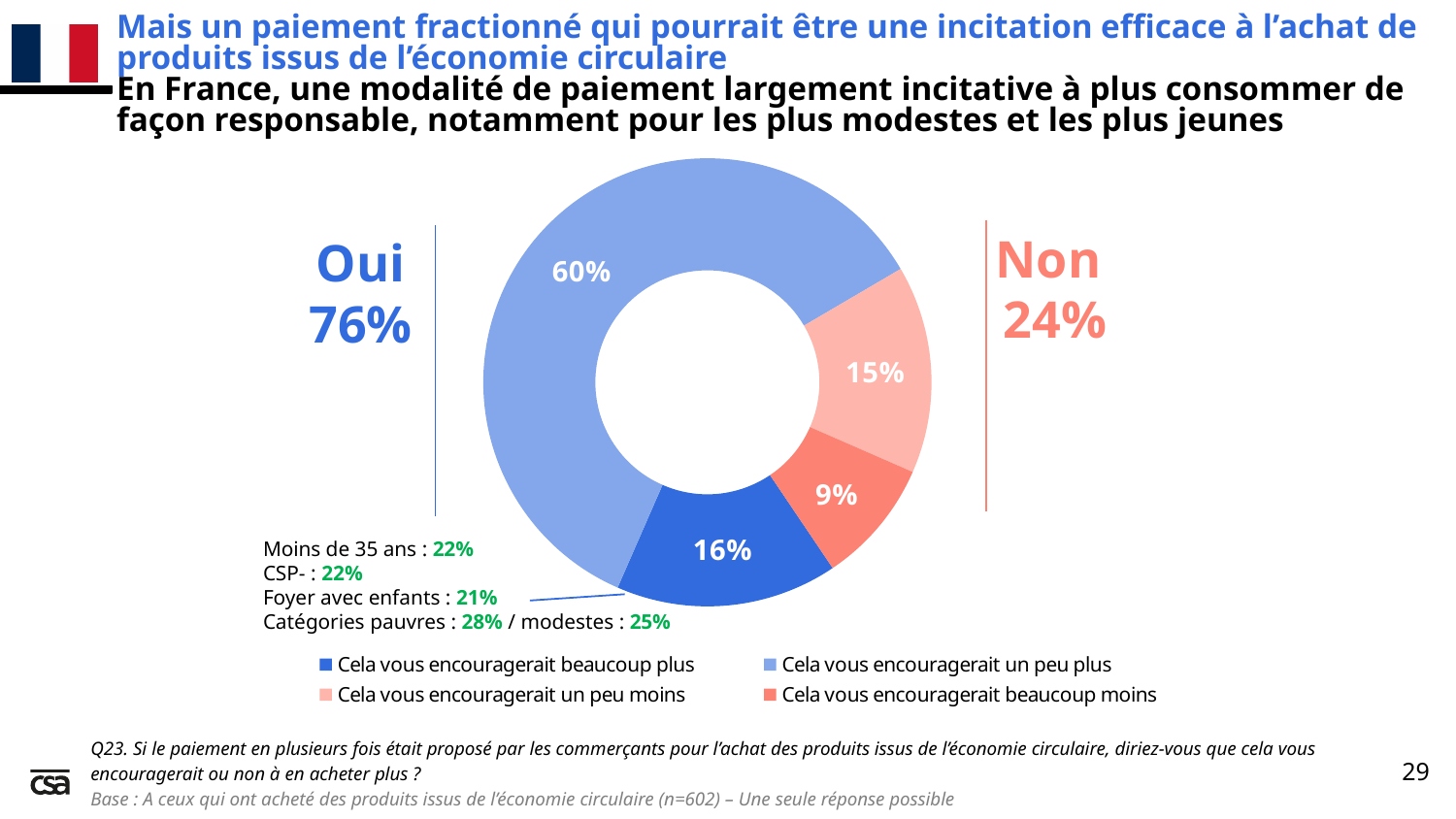
What total percentage is shown for "Non" on the slide? 24% What share of respondents answered "Cela vous encouragerait un peu plus"? 60% What total percentage is shown for "Oui" on the slide? 76% What kind of chart is shown on the slide? Pie chart (donut) What share of respondents answered "Cela vous encouragerait beaucoup plus"? 16% Which is larger: the "beaucoup plus" slice or the "un peu moins" slice? Cela vous encouragerait beaucoup plus Which response has the smallest slice of the chart? Cela vous encouragerait beaucoup moins Which response has the largest slice of the chart? Cela vous encouragerait un peu plus What share of respondents answered "Cela vous encouragerait un peu moins"? 15% How many slices does the chart have? 4 What is the difference between the "un peu plus" slice and the "beaucoup plus" slice? 44 percentage points What share of respondents answered "Cela vous encouragerait beaucoup moins"? 9%